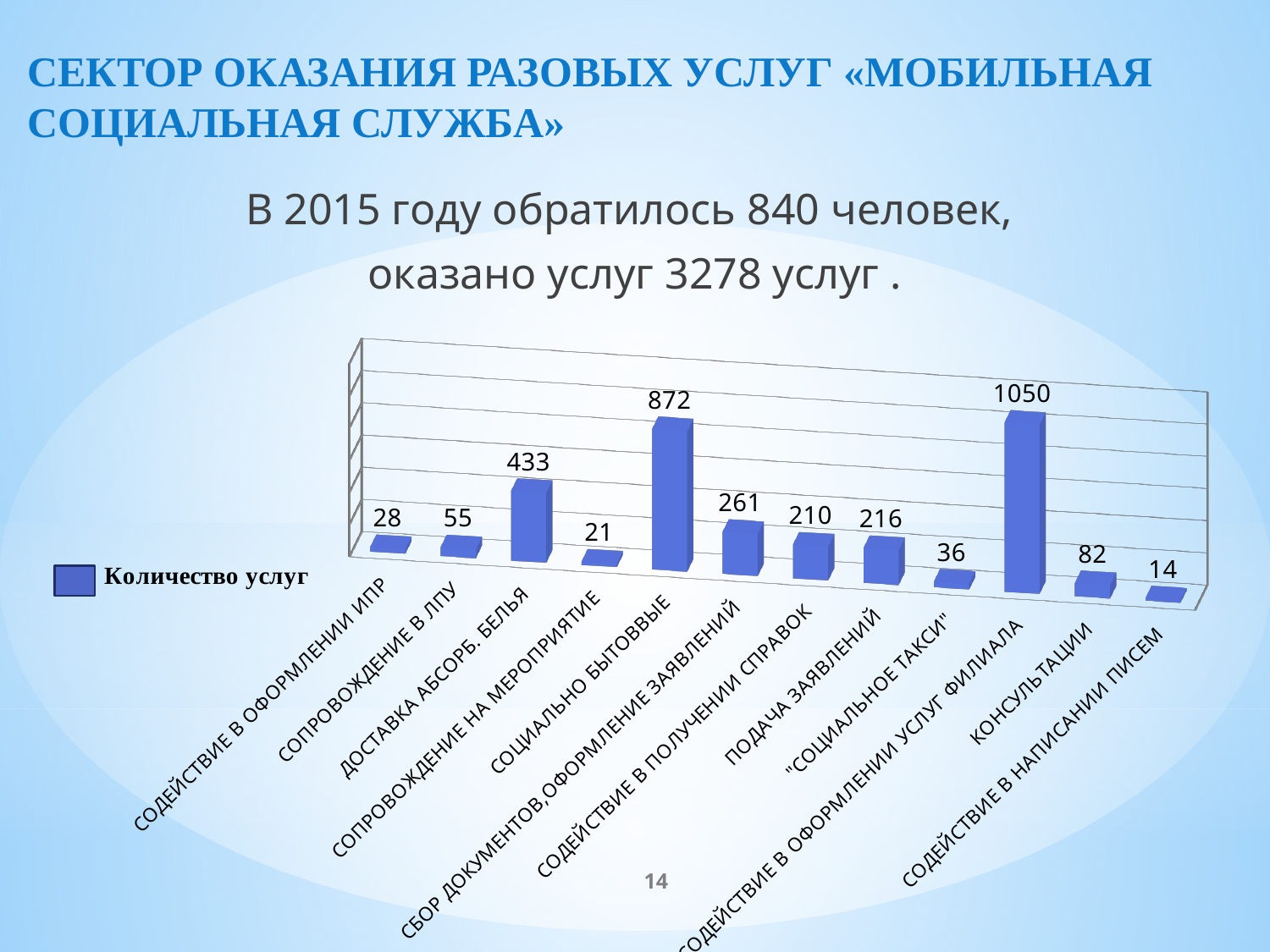
Which is larger, the value for СОПРОВОЖДЕНИЕ В ЛПУ or the value for "СОЦИАЛЬНОЕ ТАКСИ"? СОПРОВОЖДЕНИЕ В ЛПУ What type of chart is shown on the slide? Bar chart How many series does the legend list? 1 Which category has the lowest value? СОДЕЙСТВИЕ В НАПИСАНИИ ПИСЕМ Which category has the highest value? СОДЕЙСТВИЕ В ОФОРМЛЕНИИ УСЛУГ ФИЛИАЛА What is the value for СОЦИАЛЬНО БЫТОВЫЕ? 872 What is the legend entry for the series in the chart? Количество услуг How many categories are plotted in the chart? 12 What is the value for ДОСТАВКА АБСОРБ. БЕЛЬЯ? 433 What is the difference between the values for СОДЕЙСТВИЕ В ОФОРМЛЕНИИ УСЛУГ ФИЛИАЛА and СОЦИАЛЬНО БЫТОВЫЕ? 178 What is the value for СБОР ДОКУМЕНТОВ, ОФОРМЛЕНИЕ ЗАЯВЛЕНИЙ? 261 What is the value for КОНСУЛЬТАЦИИ? 82